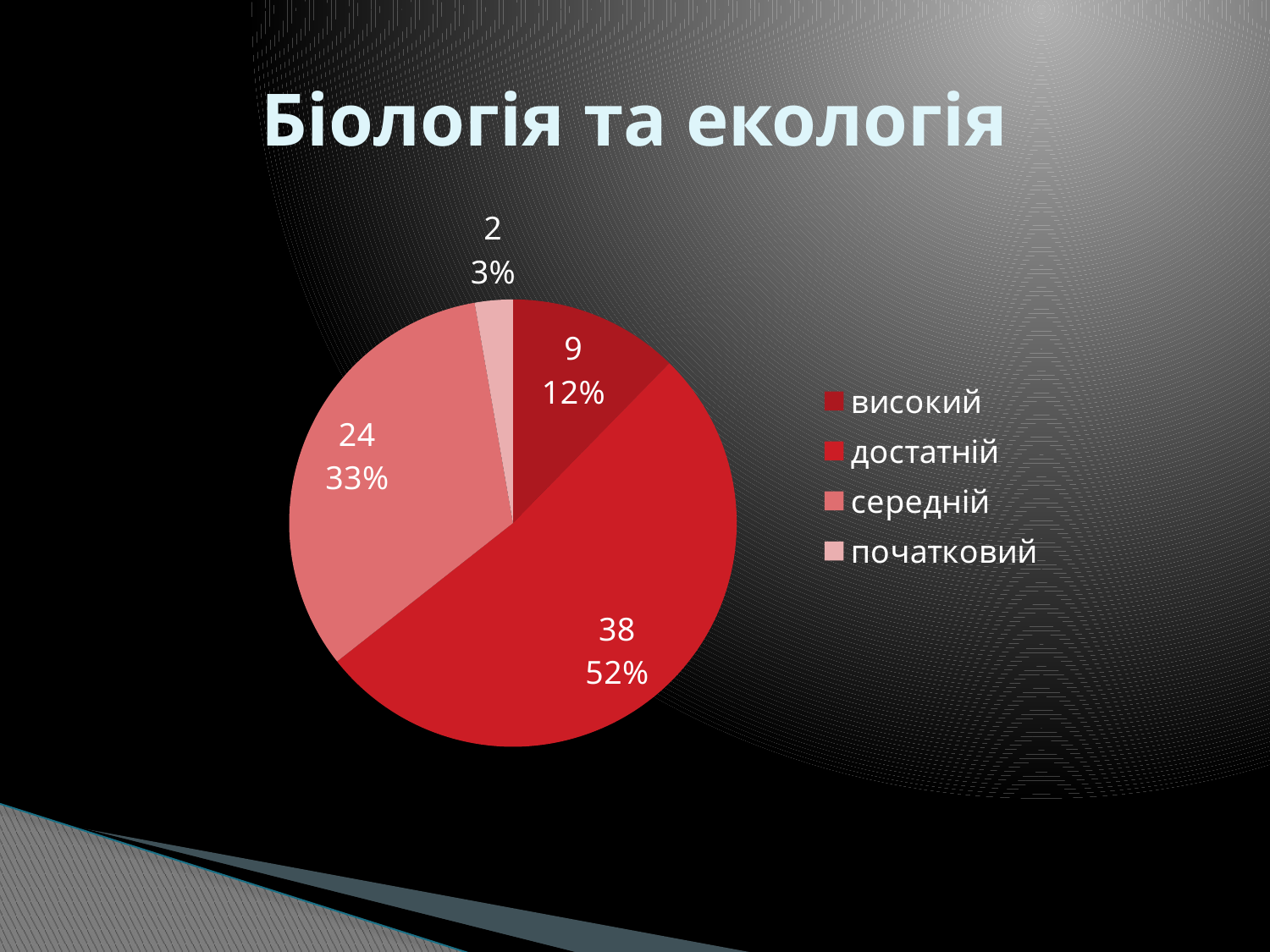
What kind of chart is shown on the slide? pie chart How many categories does the legend list? 4 Which category has the largest slice? достатній What share of the pie does середній take? 33% What is the value for середній? 24 Which is larger, the value for високий or the value for середній? середній What share of the pie does високий take? 12% Which category has the smallest slice? початковий What is the value for початковий? 2 What is the difference between the values for достатній and середній? 14 What is the value for достатній? 38 What is the value for високий? 9